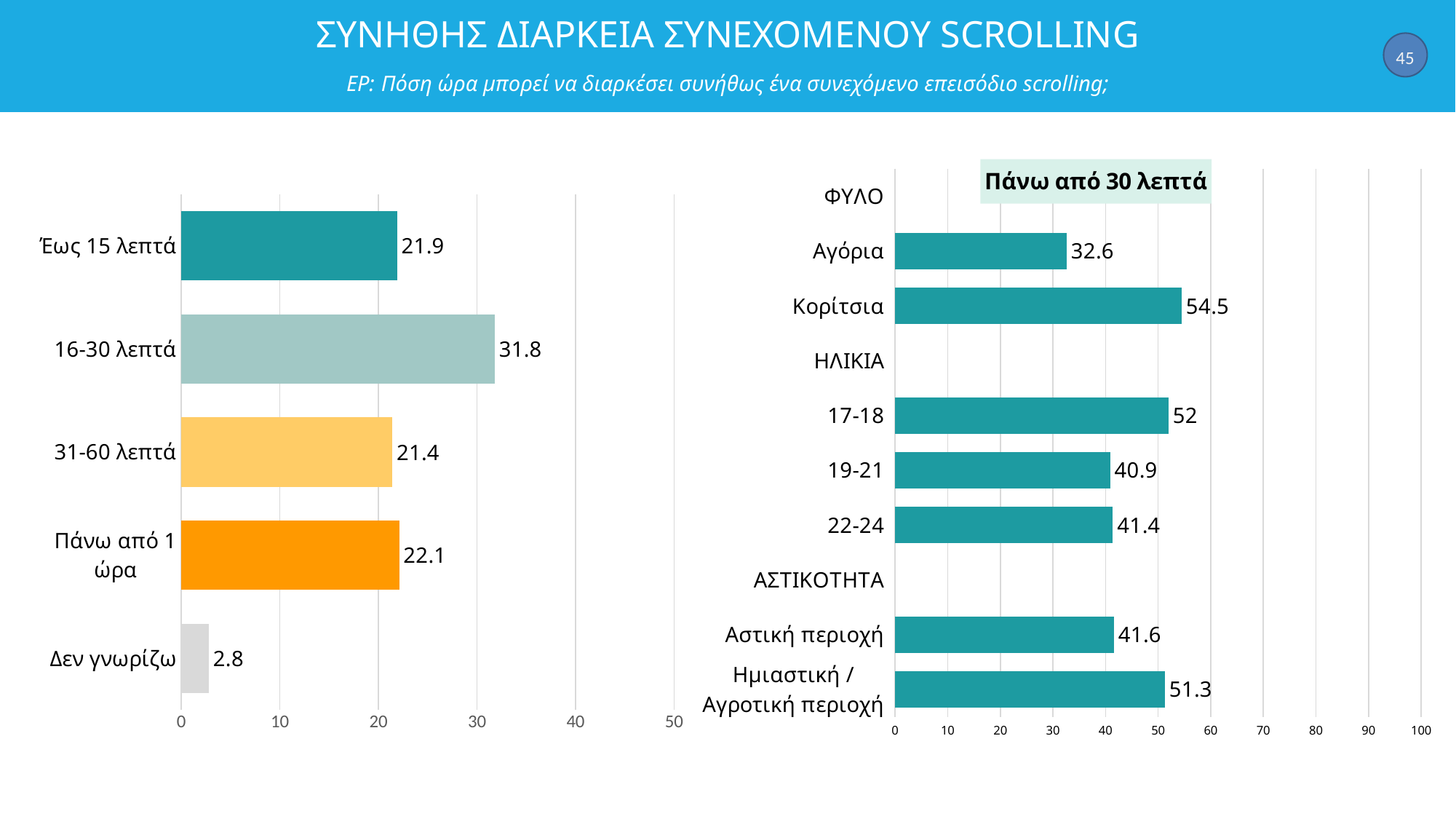
In the right chart 'Πάνω από 30 λεπτά', which category has the lowest value? Αγόρια In the left chart, how many categories are shown? 5 In the right chart 'Πάνω από 30 λεπτά', how many bars are plotted? 7 In the right chart 'Πάνω από 30 λεπτά', what is the value for '19-21'? 40.9 In the left chart, what kind of chart is it? Bar chart In the right chart 'Πάνω από 30 λεπτά', which is larger: 'Αστική περιοχή' or 'Ημιαστική / Αγροτική περιοχή'? Ημιαστική / Αγροτική περιοχή In the left chart, what is the difference between '16-30 λεπτά' and 'Έως 15 λεπτά'? 9.9 In the left chart, which category has the highest value? 16-30 λεπτά In the left chart, which category has the lowest value? Δεν γνωρίζω In the left chart, what is the value for '16-30 λεπτά'? 31.8 In the right chart 'Πάνω από 30 λεπτά', what is the value for 'Κορίτσια'? 54.5 In the right chart 'Πάνω από 30 λεπτά', what is the difference between 'Κορίτσια' and 'Αγόρια'? 21.9